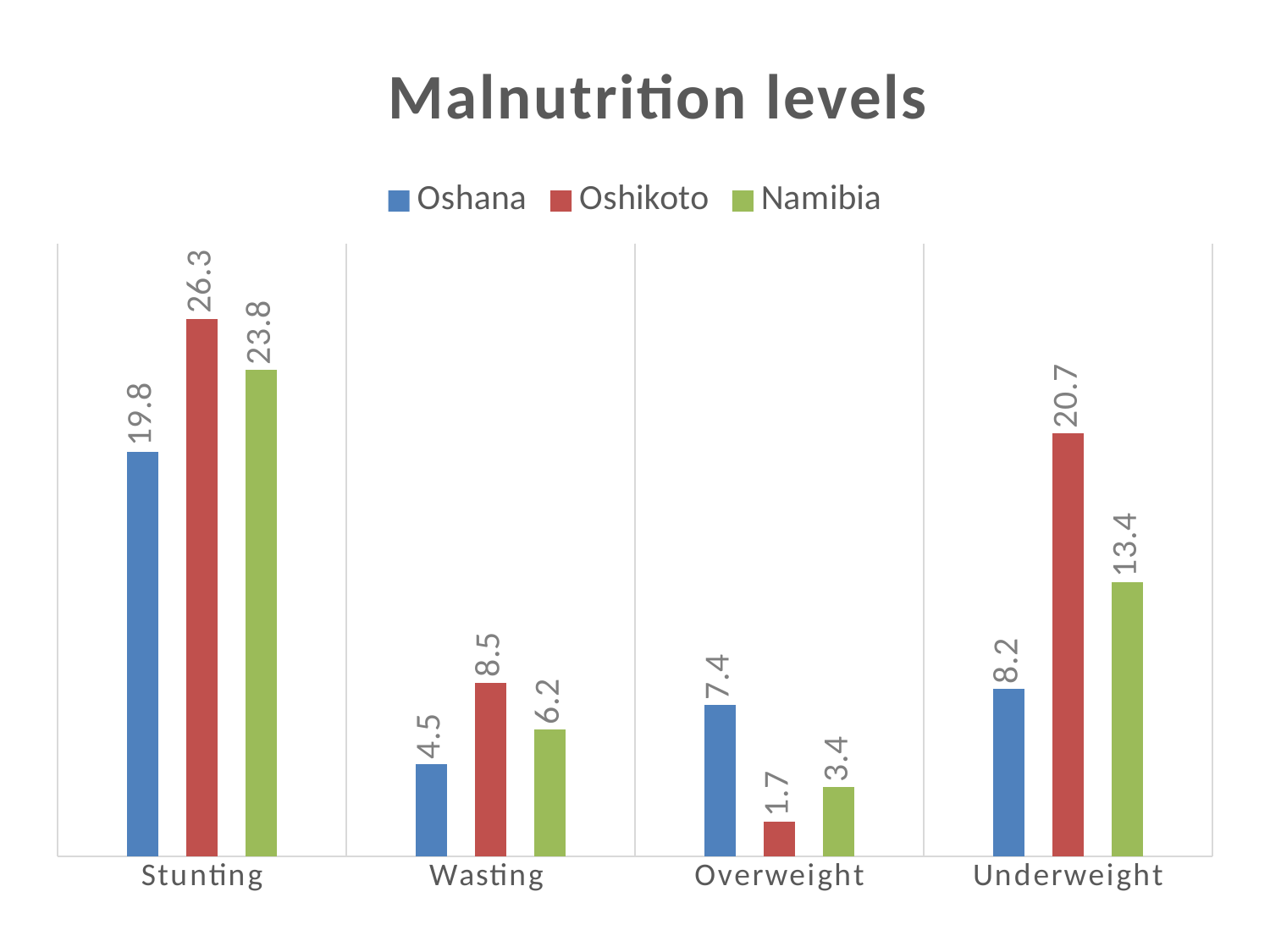
Which is larger in the Overweight category, the value for Oshana or the value for Namibia? Oshana How many series does the legend list? 3 Which category has the lowest value for Oshana? Wasting Which colour represents Namibia in the chart? Green What is the difference between the Oshikoto and Oshana values in the Underweight category? 12.5 What is the value for Oshikoto in the Stunting category? 26.3 What is the title of the chart? Malnutrition levels What is the value for Oshana in the Overweight category? 7.4 What kind of chart is shown on the slide? Bar chart What is the value for Namibia in the Underweight category? 13.4 Which category has the highest value for Oshikoto? Stunting How many categories are shown on the x axis? 4